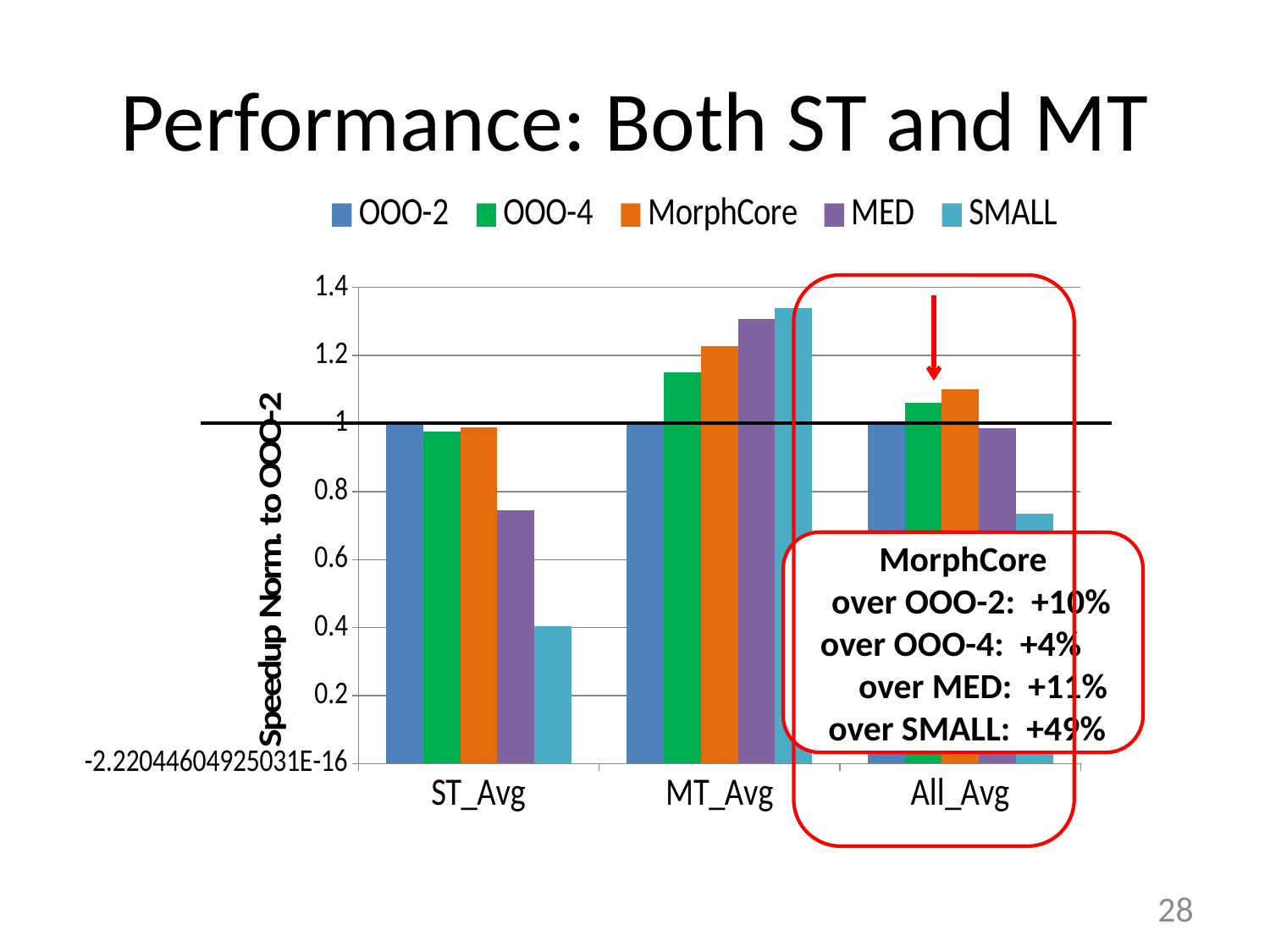
What kind of chart is shown on the slide? bar chart Is the value for SMALL in the All_Avg category greater or less than 0.8? less Is the value for MED in the ST_Avg category greater or less than 0.8? less How many categories are shown on the x axis? 3 What is the title of the y axis? Speedup Norm. to OOO-2 Which series has the highest value in the All_Avg category? MorphCore Which series has the highest value in the MT_Avg category? SMALL How many series does the legend list? 5 Is the value for SMALL in the MT_Avg category greater or less than 1.2? greater What is the value for OOO-2 in the MT_Avg category? 1 Which series has the lowest value in the ST_Avg category? SMALL Which is larger: the value for MED in ST_Avg or the value for MED in MT_Avg? MED in MT_Avg